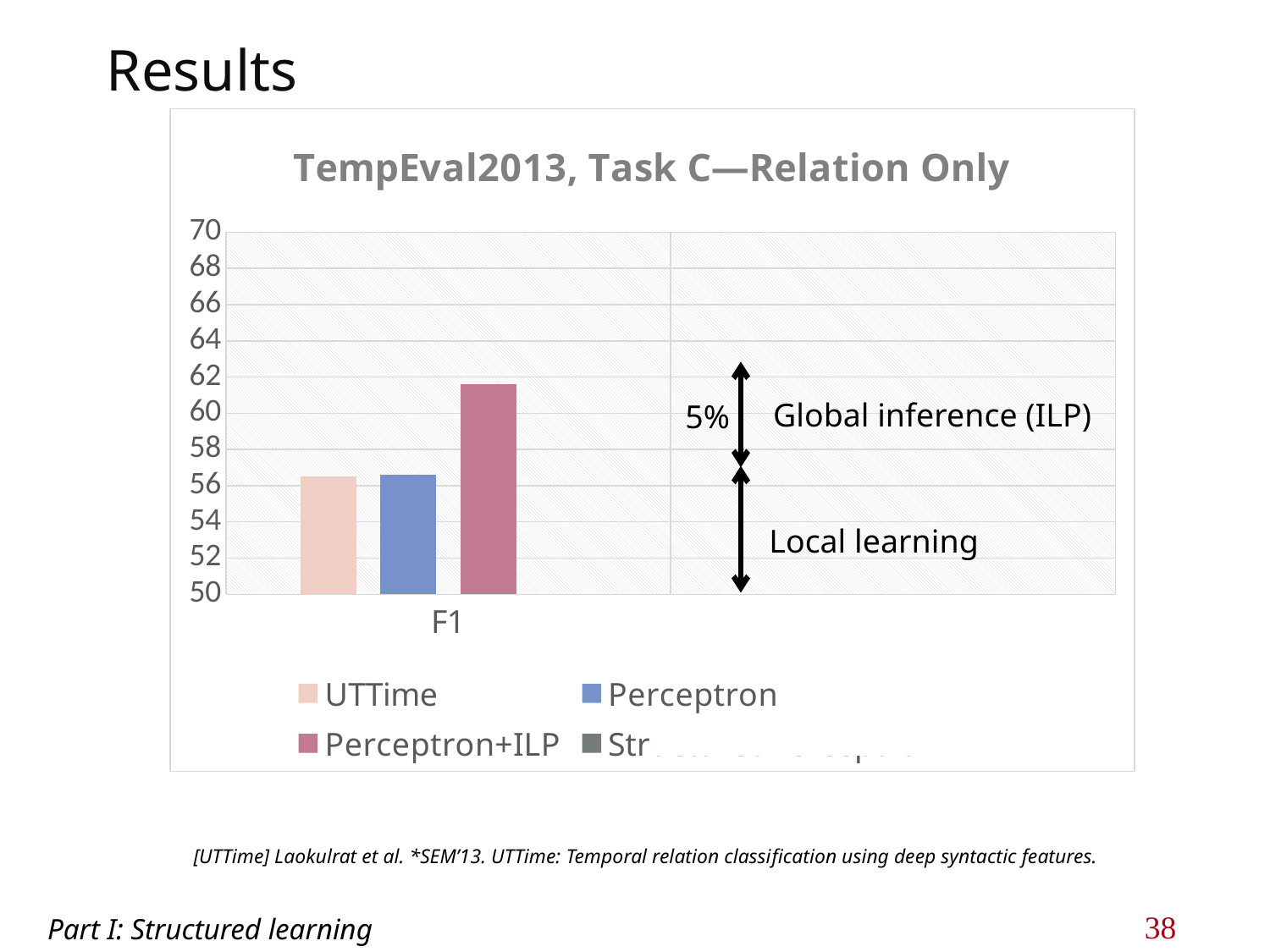
What improvement percentage is annotated next to the arrow labelled Global inference (ILP)? 5% Which series has the highest F1 value in the chart? Perceptron+ILP What is the label of the category on the x axis? F1 Is the F1 value for Perceptron+ILP greater or less than 64? less What kind of chart is shown on the slide? bar chart Is the F1 value for Perceptron greater or less than 60? less Is the F1 value for Perceptron+ILP greater or less than 60? greater What is the title of the chart? TempEval2013, Task C—Relation Only Which has a larger F1 value, Perceptron or Perceptron+ILP? Perceptron+ILP How many categories are shown on the x axis of the chart? 1 Which has a larger F1 value, UTTime or Perceptron+ILP? Perceptron+ILP